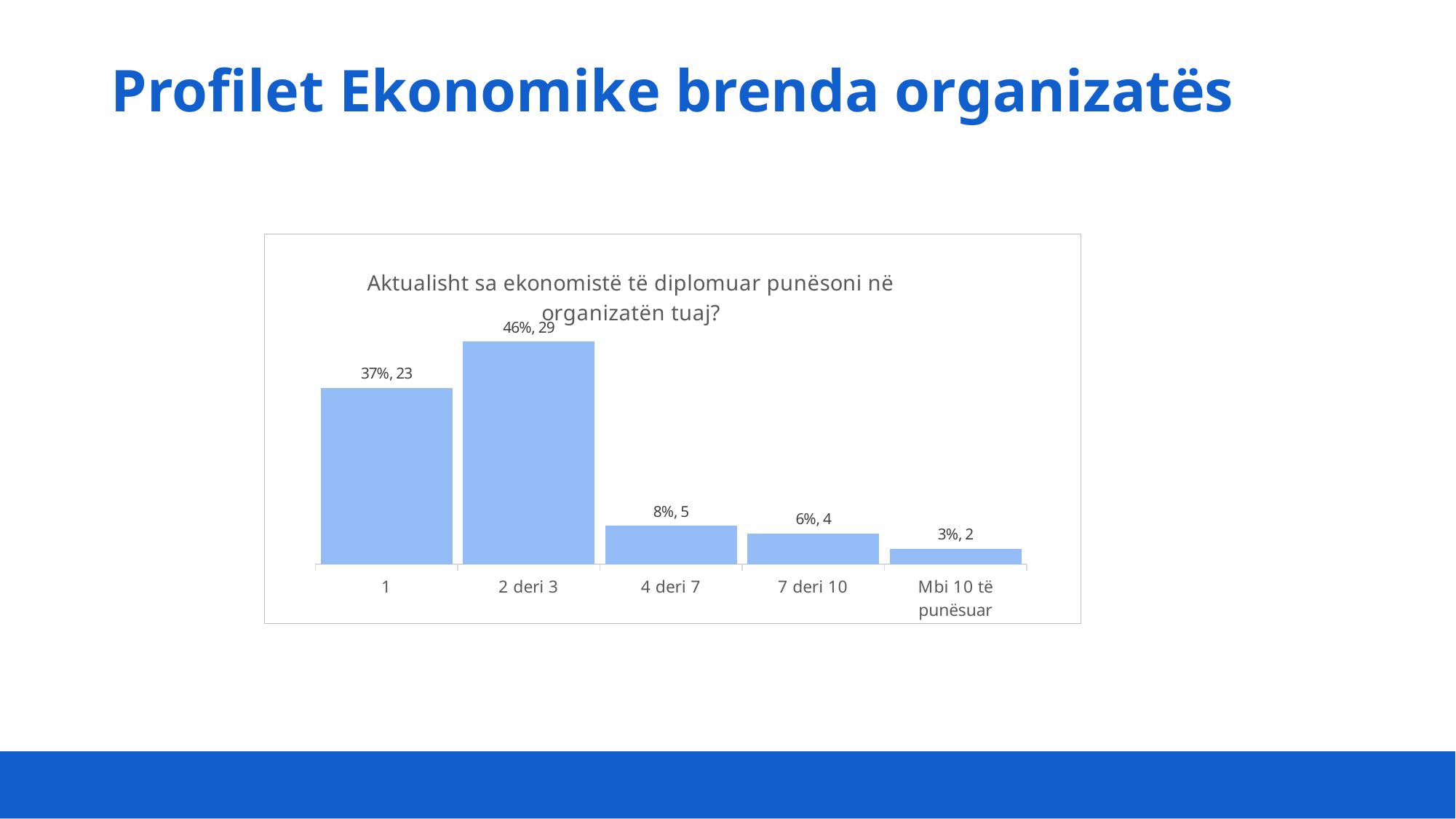
What is the data label for the category "2 deri 3"? 46%, 29 Which is larger, the value for "4 deri 7" or the value for "7 deri 10"? 4 deri 7 What kind of chart is shown on the slide? bar chart What is the difference in percentage between "7 deri 10" and "Mbi 10 të punësuar"? 3% What is the data label for the category "1"? 37%, 23 What is the chart's title? Aktualisht sa ekonomistë të diplomuar punësoni në organizatën tuaj? Which category has the lowest value? Mbi 10 të punësuar What is the data label for the category "4 deri 7"? 8%, 5 What is the data label for the category "Mbi 10 të punësuar"? 3%, 2 What is the difference in count between "2 deri 3" and "1"? 6 How many categories are shown on the x axis? 5 Which category has the highest value? 2 deri 3